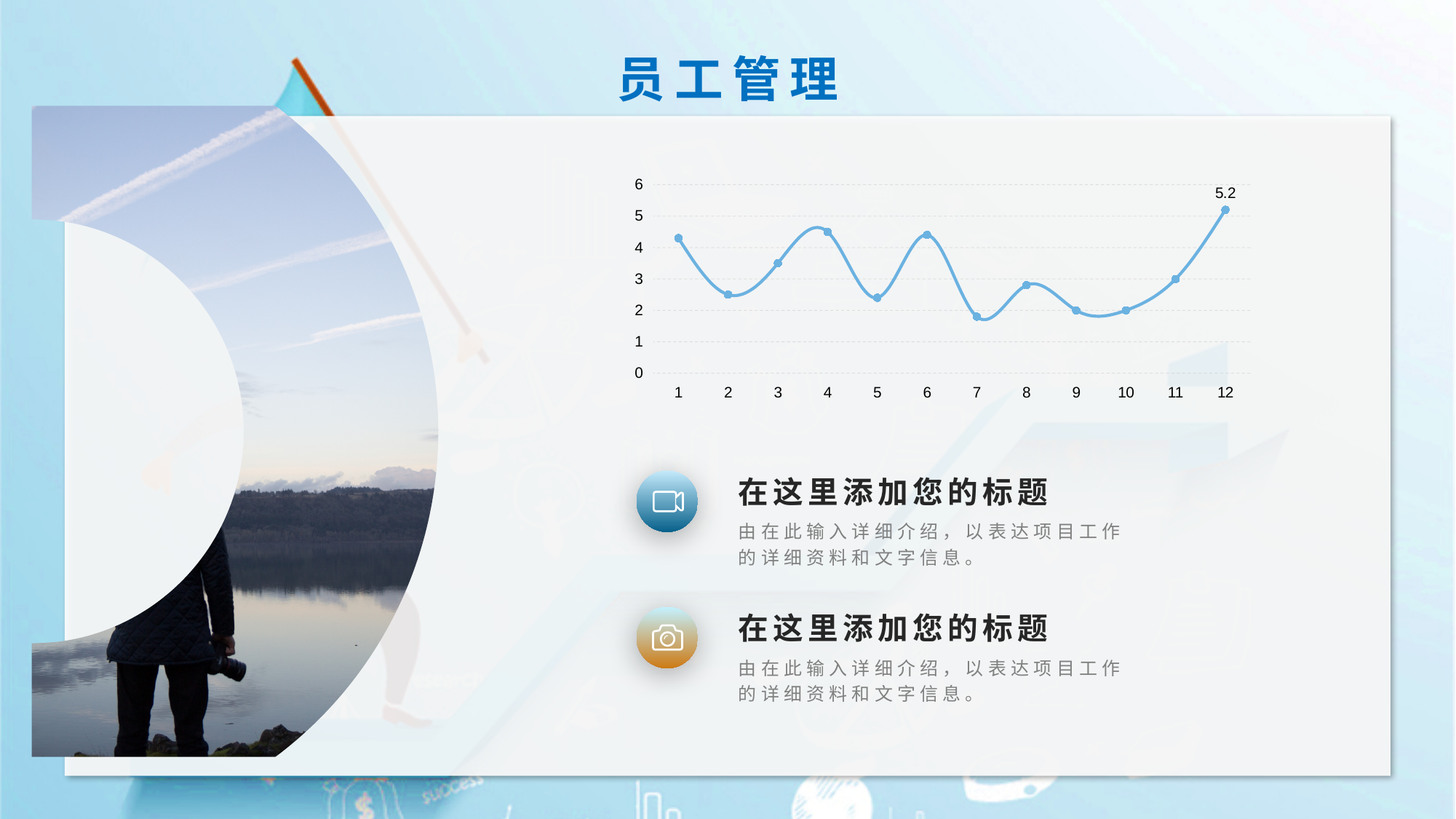
Is the value at x = 2 greater or less than 3? less Is the value at x = 1 greater or less than 4? greater Which has the larger value, x = 4 or x = 5? 4 How many data points are plotted on the line? 12 Do the values rise or fall from x = 10 to x = 12? rise What is the value plotted at x = 12? 5.2 Which has the larger value, x = 12 or x = 1? 12 Is the value at x = 4 greater or less than 4? greater What type of chart is shown on the slide? line chart At which x-axis category does the line reach its highest value? 12 What is the highest value shown on the vertical axis? 6